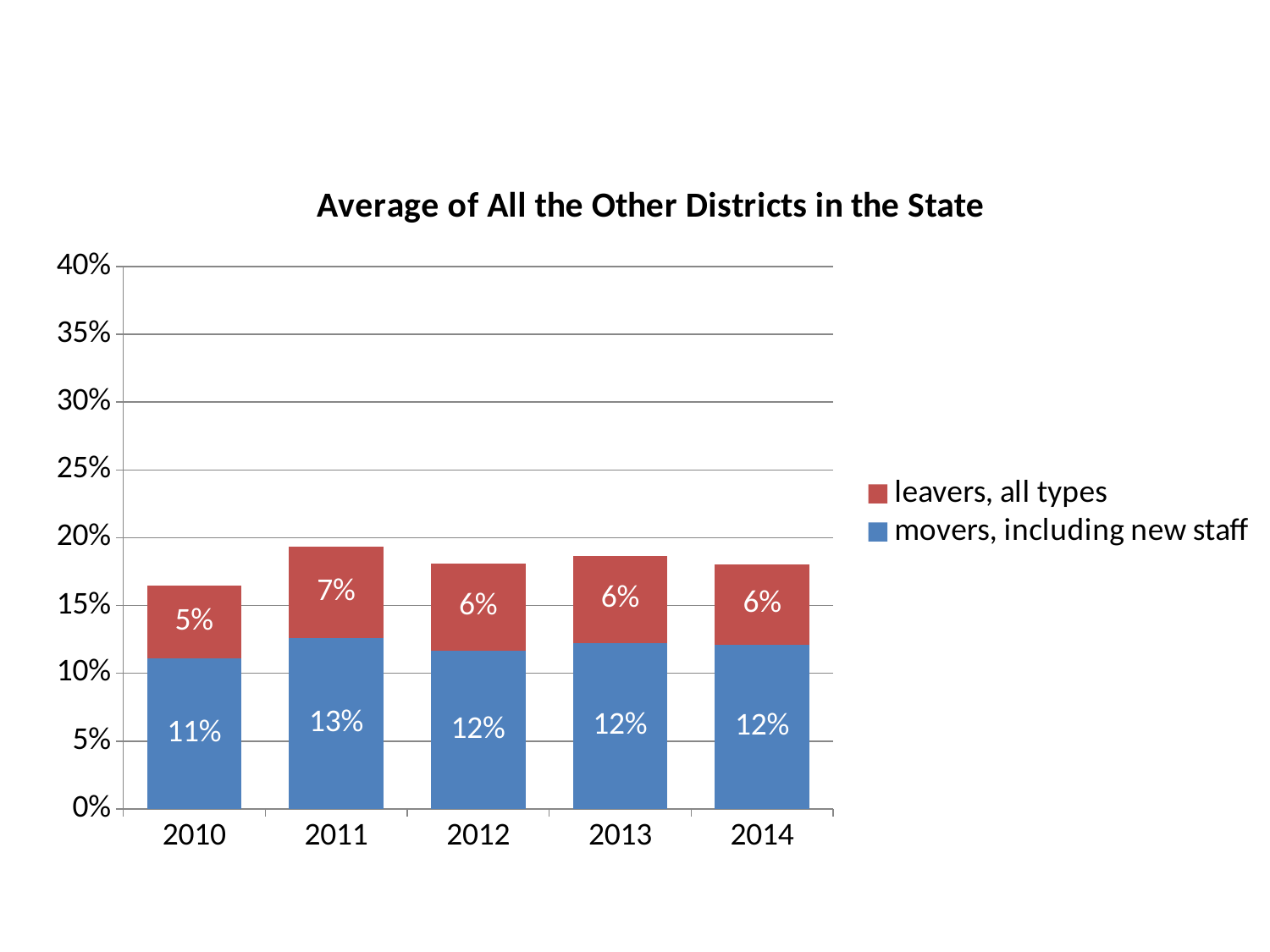
What is the value for movers, including new staff in 2011? 13% How many series does the legend list? 2 What is the difference between the movers, including new staff values for 2011 and 2010? 2% What is the value for leavers, all types in 2014? 6% In which year is the movers, including new staff value highest? 2011 In which year is the leavers, all types value lowest? 2010 Which is larger: leavers, all types in 2011 or leavers, all types in 2012? 2011 What is the value for leavers, all types in 2010? 5% What kind of chart is shown on the slide? stacked bar chart Is the total height of the 2010 bar greater or less than 20%? less How many years are shown on the x axis? 5 What is the title of the chart? Average of All the Other Districts in the State